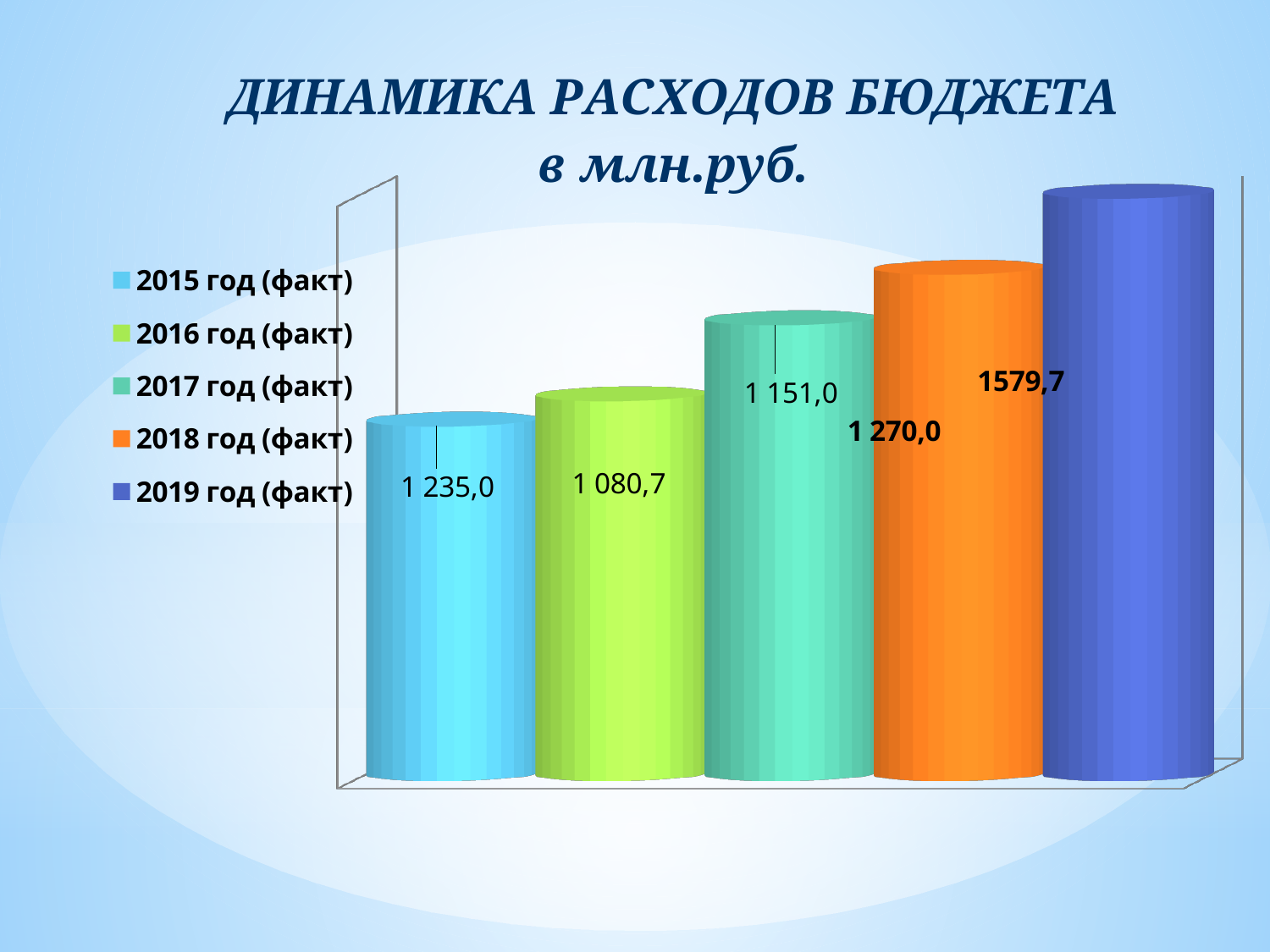
What is the title of the chart? ДИНАМИКА РАСХОДОВ БЮДЖЕТА в млн.руб. What colour is used for the 2018 год (факт) series in the legend? orange Which is larger, the value for 2018 год (факт) or 2019 год (факт)? 2019 год (факт) What is the value labelled on the 2017 год (факт) bar? 1 151,0 What kind of chart is shown on the slide? bar chart What is the difference between the 2019 год (факт) value and the 2018 год (факт) value? 309,7 What is the value labelled on the 2018 год (факт) bar? 1 270,0 What is the value labelled on the 2016 год (факт) bar? 1 080,7 How many bars are plotted in the chart? 5 How many series does the legend list? 5 What is the value labelled on the 2019 год (факт) bar? 1579,7 Which year has the highest value in the chart? 2019 год (факт)